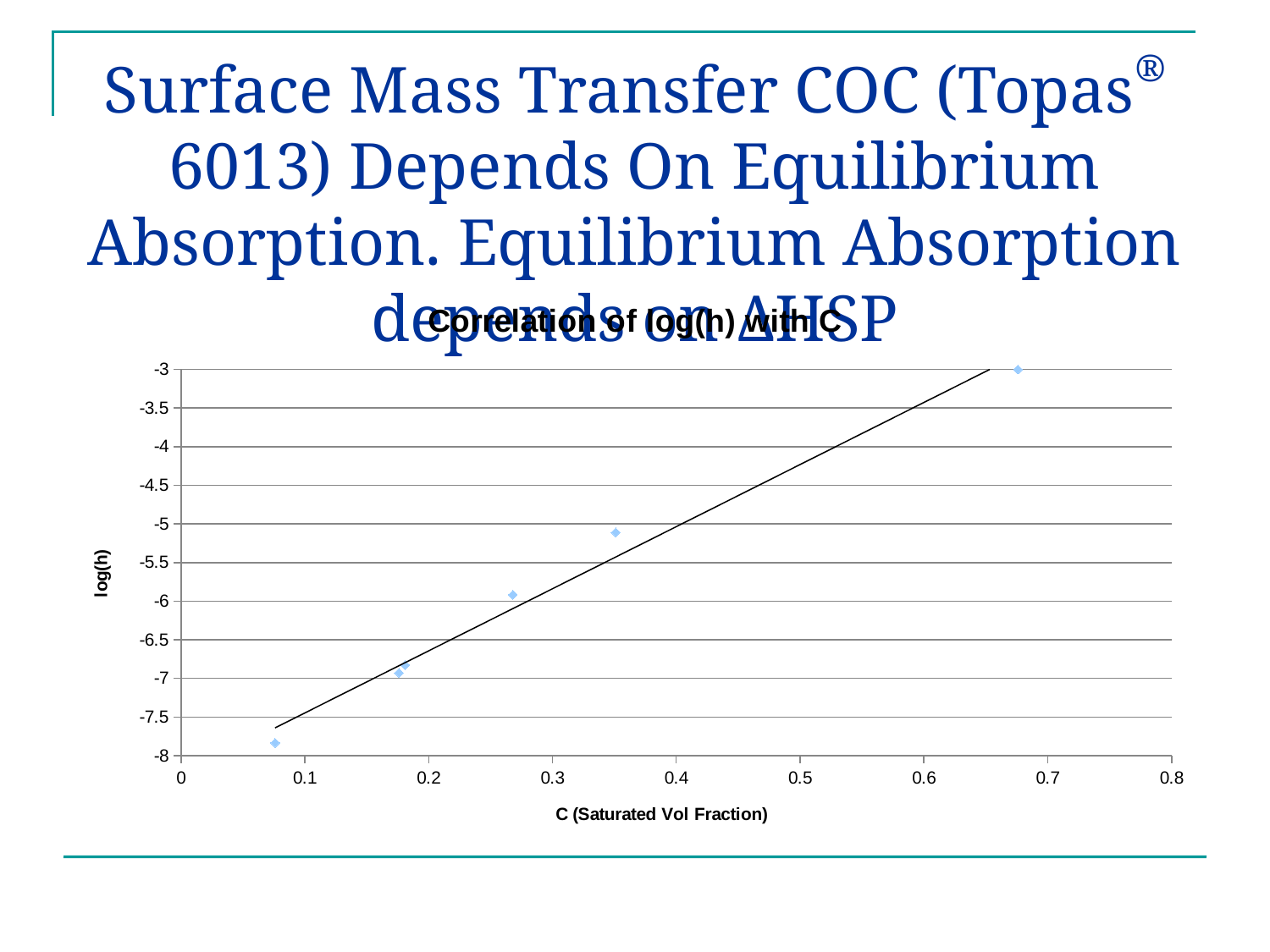
What is the title of the chart? Correlation of log(h) with C Is the log(h) value for the data point near C = 0.27 greater or less than -5.5? less Is the log(h) value for the data point near C = 0.35 greater or less than -4.5? less Is the log(h) value for the data point with the lowest C greater or less than -7.5? less Does log(h) rise or fall as C increases along the x axis? rise What is the log(h) value of the data point with the highest C? -3 How many data points are plotted on the chart? 6 What kind of chart is shown on the slide? scatter chart Which data point has the highest log(h): the one with the lowest C or the one with the highest C? the one with the highest C What is the label of the x axis of the chart? C (Saturated Vol Fraction)